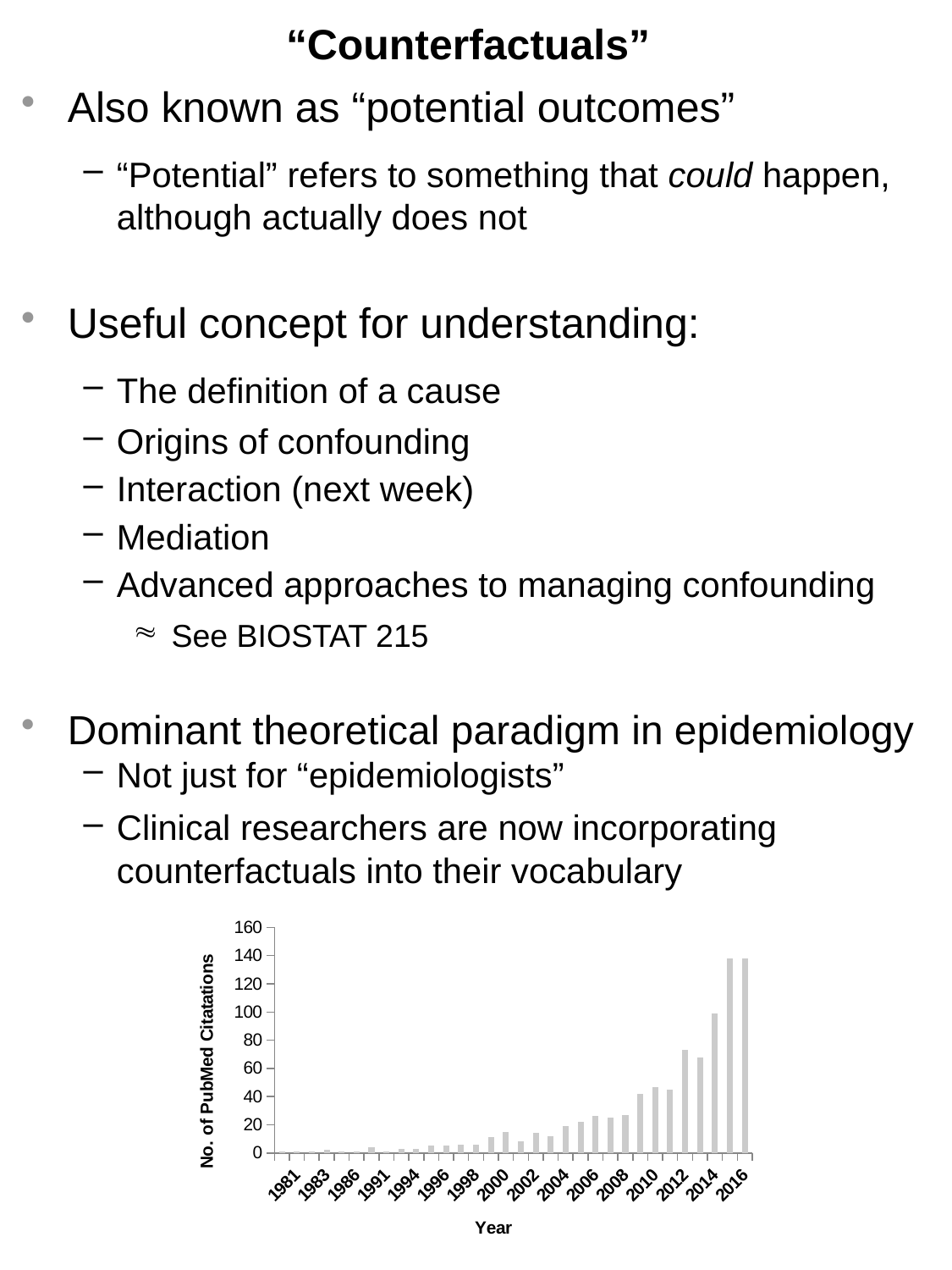
What kind of chart is shown at the bottom of the slide? bar chart Is the value for 2010 greater or less than 20? greater Which year has more PubMed citations, 2012 or 2000? 2012 Is the value for 2000 greater or less than 40? less What is the title of the horizontal axis of the chart? Year Is the value for 2016 greater or less than 120? greater Do the number of PubMed citations generally rise or fall from 1981 to 2016? rise What is the title of the vertical axis of the chart? No. of PubMed Citatations Which year has more PubMed citations, 1981 or 2016? 2016 What is the highest value shown on the vertical axis of the chart? 160